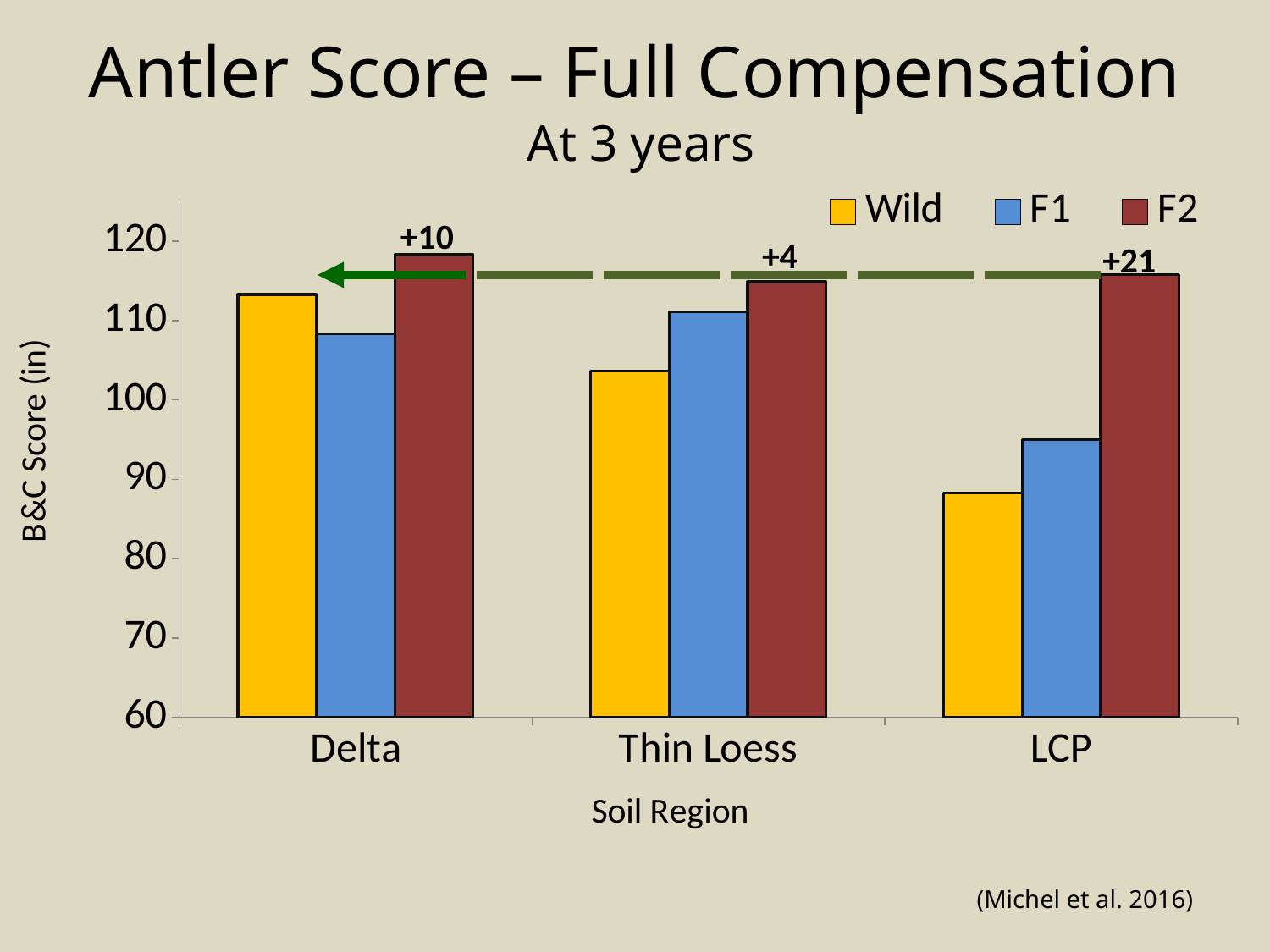
Do the Wild values rise or fall moving from Delta to LCP along the x axis? fall How many series does the legend list? 3 Which soil region has the highest Wild value? Delta Is the Wild value for LCP greater or less than 90? less What annotation is printed above the F2 bar for LCP? +21 Which series has the highest bar in the LCP group? F2 What kind of chart is shown on the slide? bar chart In the Delta group, which is larger, the Wild bar or the F1 bar? Wild How many soil regions are shown on the x axis? 3 In the LCP group, which is larger, the Wild bar or the F2 bar? F2 Is the F1 value for Delta greater or less than 110? less Which soil region has the lowest Wild value? LCP